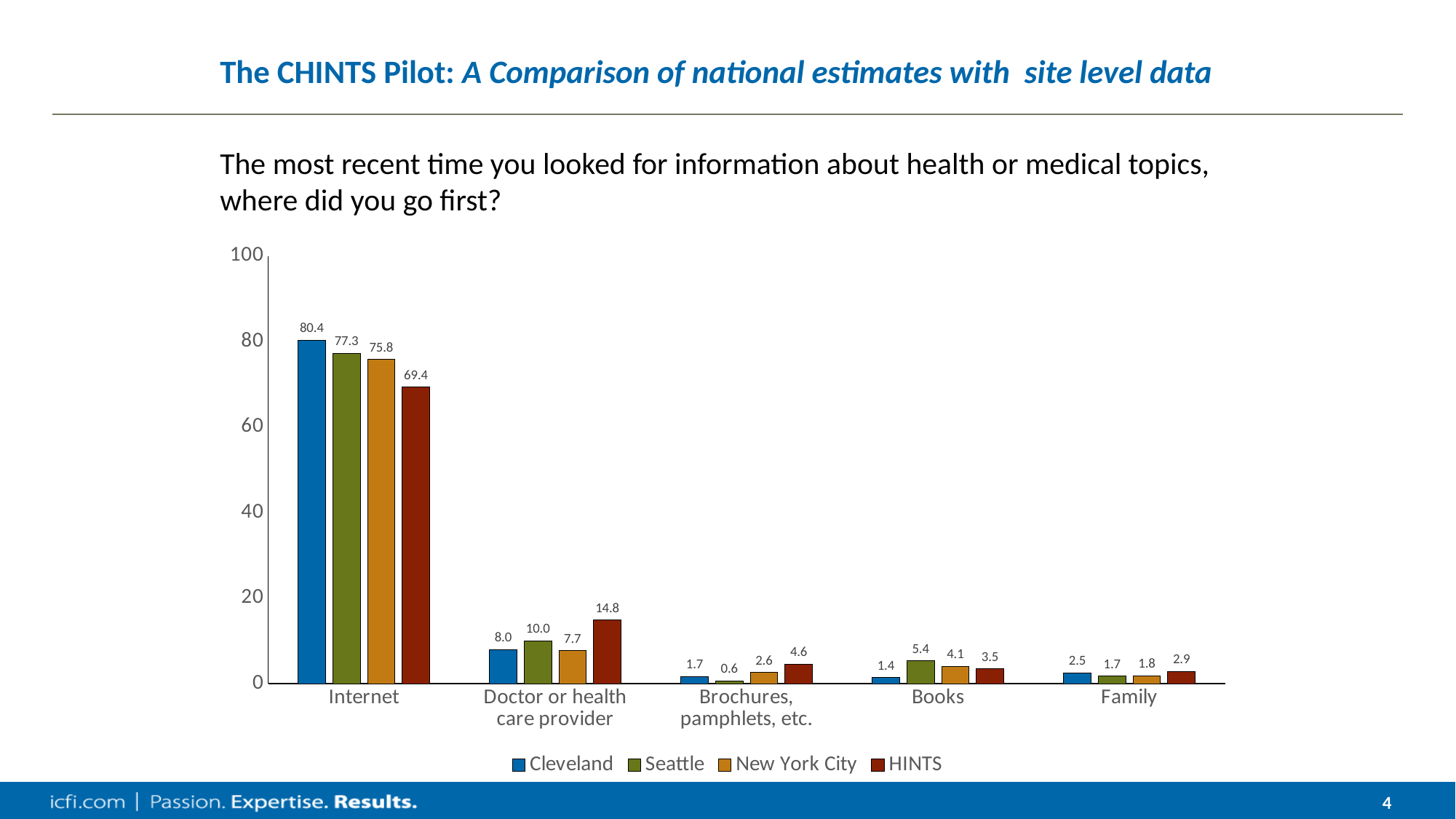
Which category has the highest value for New York City? Internet How many categories are shown on the x axis? 5 What is the value for Cleveland in the Internet category? 80.4 Is the HINTS value for Internet greater or less than 60? greater What is the Seattle value for Books? 5.4 What is the HINTS value for Doctor or health care provider? 14.8 Which is larger for Doctor or health care provider: Seattle or New York City? Seattle How many series does the legend list? 4 Which series is shown in dark red in the legend? HINTS What is the difference between the Cleveland and HINTS values for Internet? 11.0 Which series has the lowest value in the Brochures, pamphlets, etc. category? Seattle What kind of chart is shown on the slide? bar chart